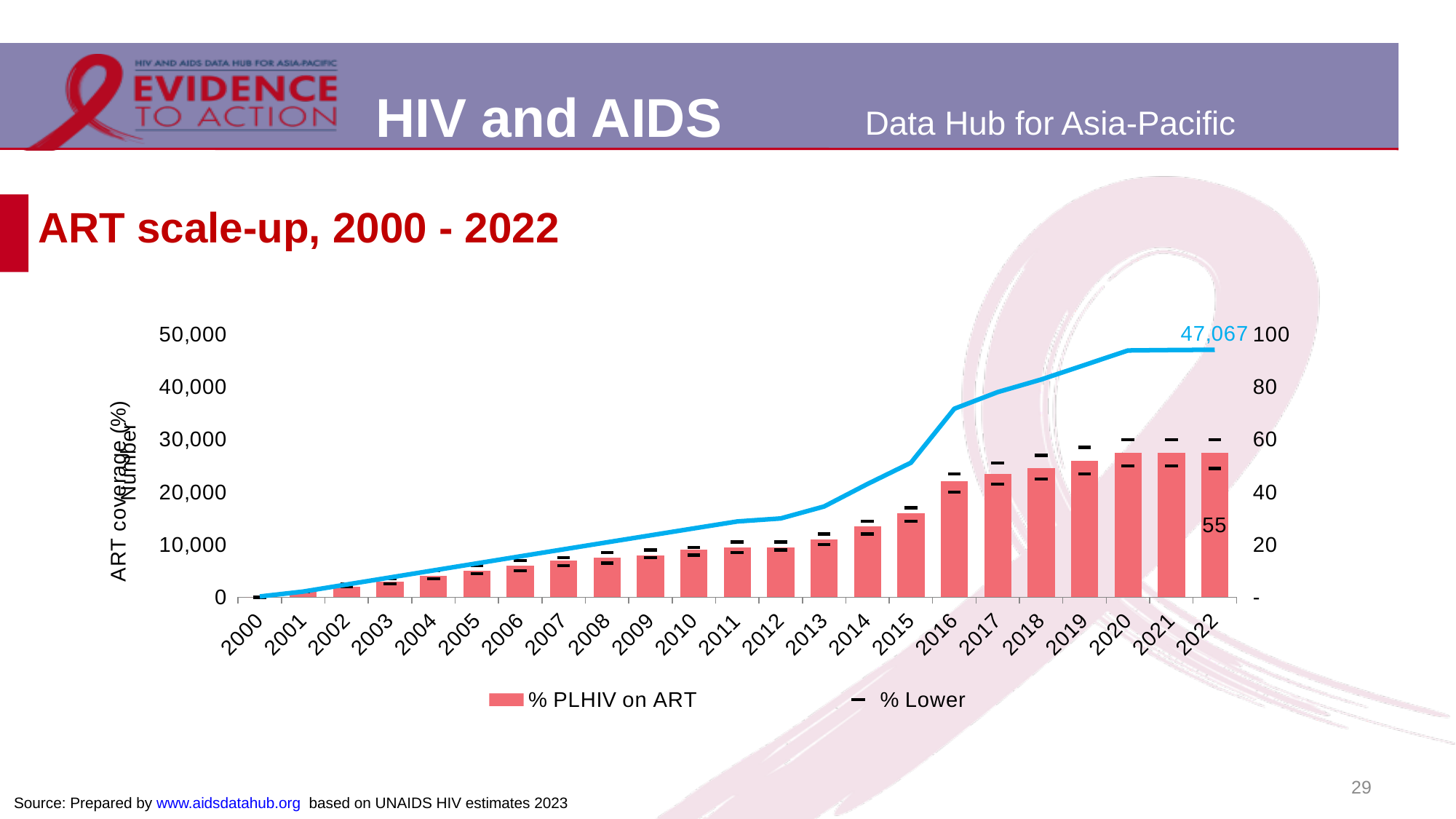
What is the title of the chart? ART scale-up, 2000 - 2022 How many series does the legend list? 2 Does the blue line rise or fall from 2000 to 2022? rise Which is larger, the % PLHIV on ART bar for 2022 or for 2010? 2022 Is the % PLHIV on ART value for 2020 greater or less than 40? greater Is the blue line value for 2016 greater or less than 30,000? greater What is the number on ART shown by the blue line's data label in 2022? 47,067 What is the value of % PLHIV on ART in 2022? 55 Which year has the lowest % PLHIV on ART bar? 2000 What kind of chart is used to show % PLHIV on ART? bar chart How many years are shown on the x axis? 23